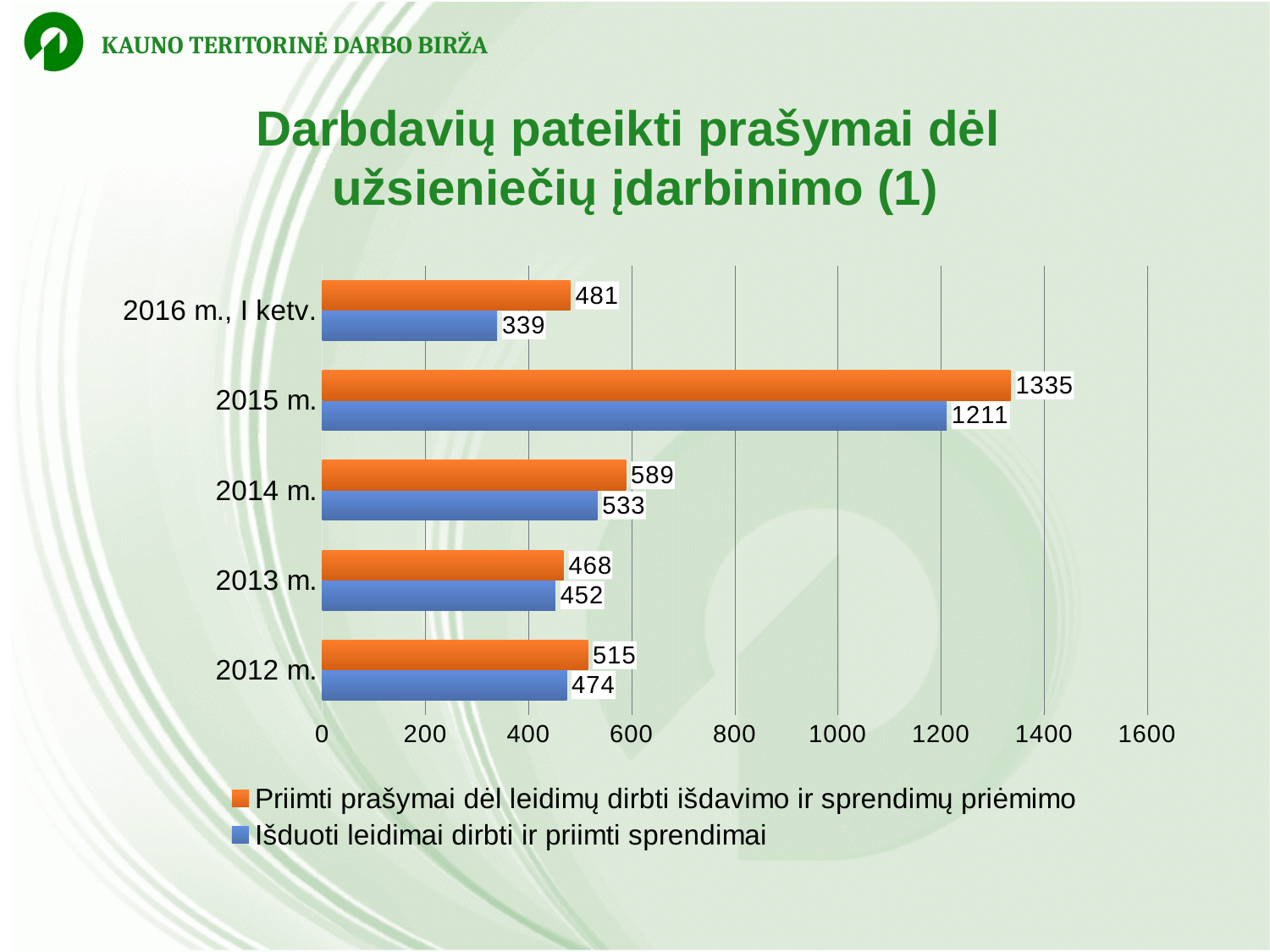
What is the difference between "Priimti prašymai dėl leidimų dirbti išdavimo ir sprendimų priėmimo" and "Išduoti leidimai dirbti ir priimti sprendimai" for 2016 m., I ketv.? 142 What is the difference between "Priimti prašymai dėl leidimų dirbti išdavimo ir sprendimų priėmimo" and "Išduoti leidimai dirbti ir priimti sprendimai" for 2015 m.? 124 What is the value of "Priimti prašymai dėl leidimų dirbti išdavimo ir sprendimų priėmimo" for 2015 m.? 1335 How many series does the legend list? 2 What kind of chart is shown on the slide? bar chart Is the value of "Išduoti leidimai dirbti ir priimti sprendimai" for 2015 m. greater or less than 1000? greater How many categories are shown on the chart? 5 What is the value of "Išduoti leidimai dirbti ir priimti sprendimai" for 2013 m.? 452 Which category has the lowest value for "Išduoti leidimai dirbti ir priimti sprendimai"? 2016 m., I ketv. Which is larger: "Priimti prašymai dėl leidimų dirbti išdavimo ir sprendimų priėmimo" for 2014 m. or for 2012 m.? 2014 m. What is the value of "Išduoti leidimai dirbti ir priimti sprendimai" for 2016 m., I ketv.? 339 Which category has the highest value for "Priimti prašymai dėl leidimų dirbti išdavimo ir sprendimų priėmimo"? 2015 m.